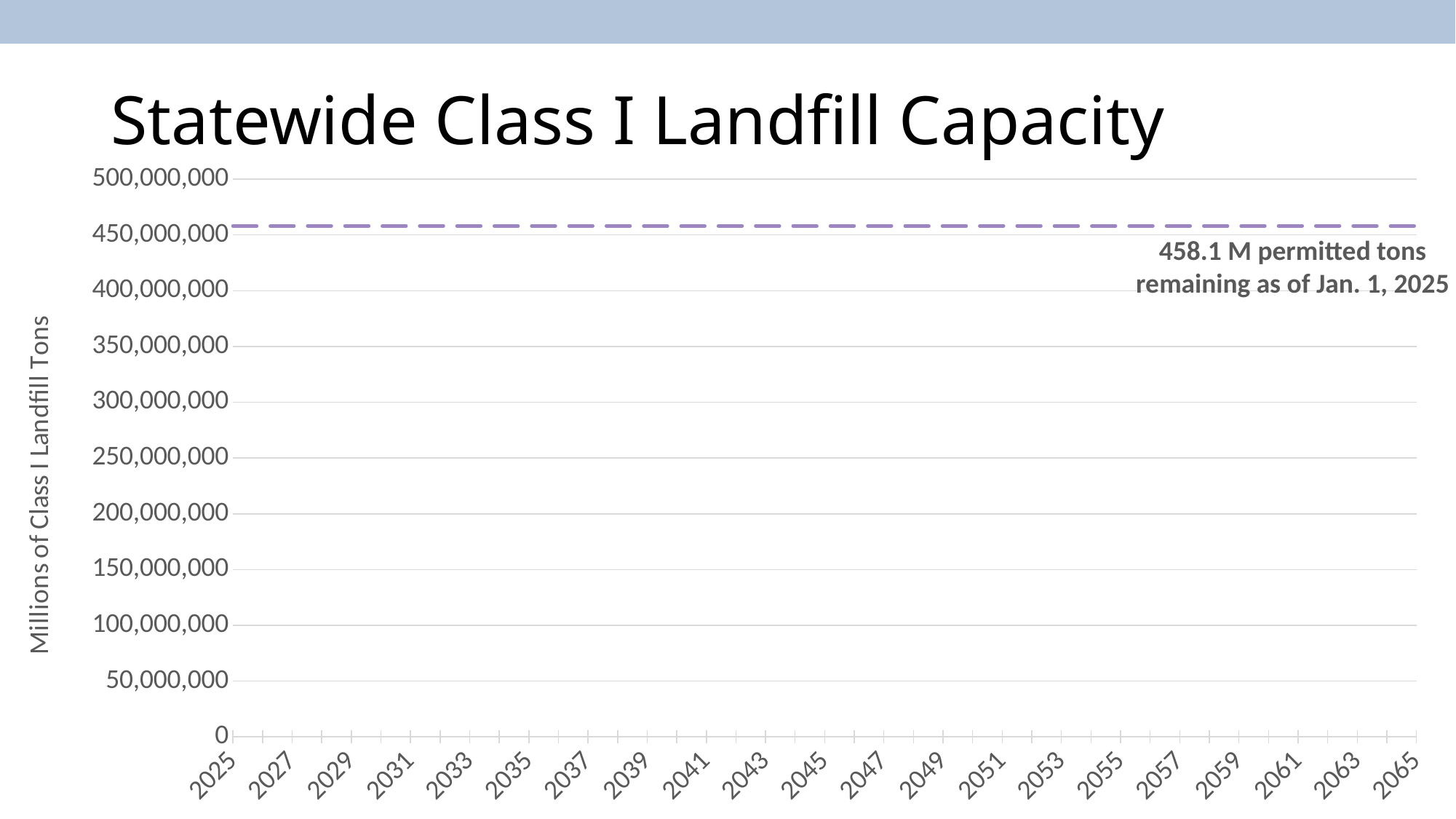
How many year labels are shown on the x axis? 21 What is the label on the vertical axis? Millions of Class I Landfill Tons What is the first year shown on the x axis? 2025 What is the title of the chart? Statewide Class I Landfill Capacity What is the last year shown on the x axis? 2065 Is the value of the dashed line in 2045 greater or less than 400,000,000? greater Does the dashed line rise, fall, or stay flat from 2025 to 2065? stays flat According to the annotation, how many permitted tons remain as of Jan. 1, 2025? 458.1 M Is the value of the dashed line greater or less than 450,000,000? greater Is the value of the dashed line greater or less than 500,000,000? less What is the highest value shown on the y axis? 500,000,000 What kind of chart is shown on the slide? line chart